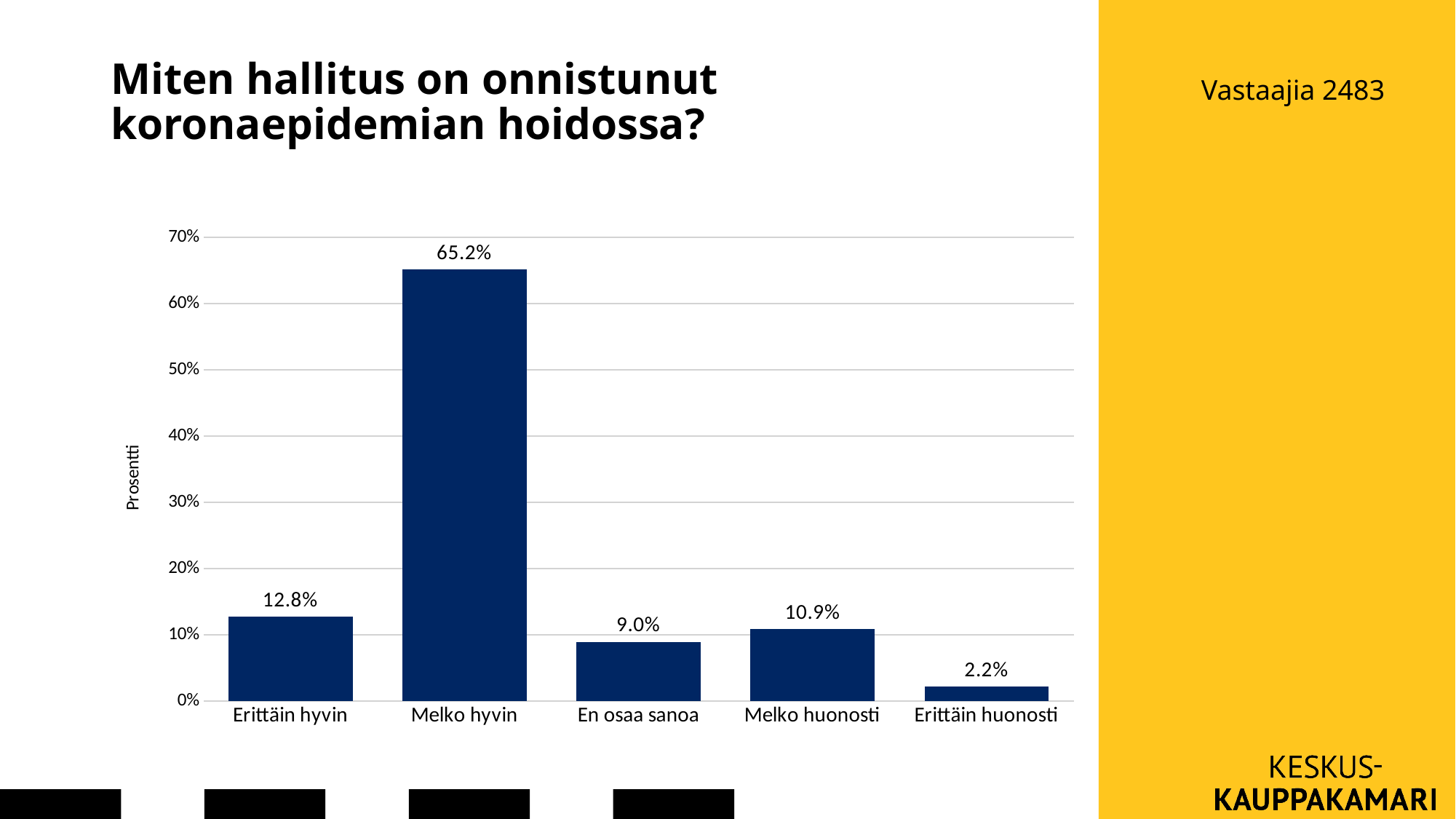
Which category has the lowest value? Erittäin huonosti What is the value for Erittäin hyvin? 12.8% How many categories are shown on the x axis? 5 What is the difference between the values for Melko hyvin and Erittäin hyvin? 52.4% What is the label of the vertical axis? Prosentti Which category has the highest value? Melko hyvin What is the value for Melko hyvin? 65.2% What is the value for En osaa sanoa? 9.0% What kind of chart is shown on the slide? bar chart Which is larger, the value for Erittäin hyvin or the value for Melko huonosti? Erittäin hyvin What is the value for Erittäin huonosti? 2.2% Is the value for Melko huonosti greater or less than 20%? less